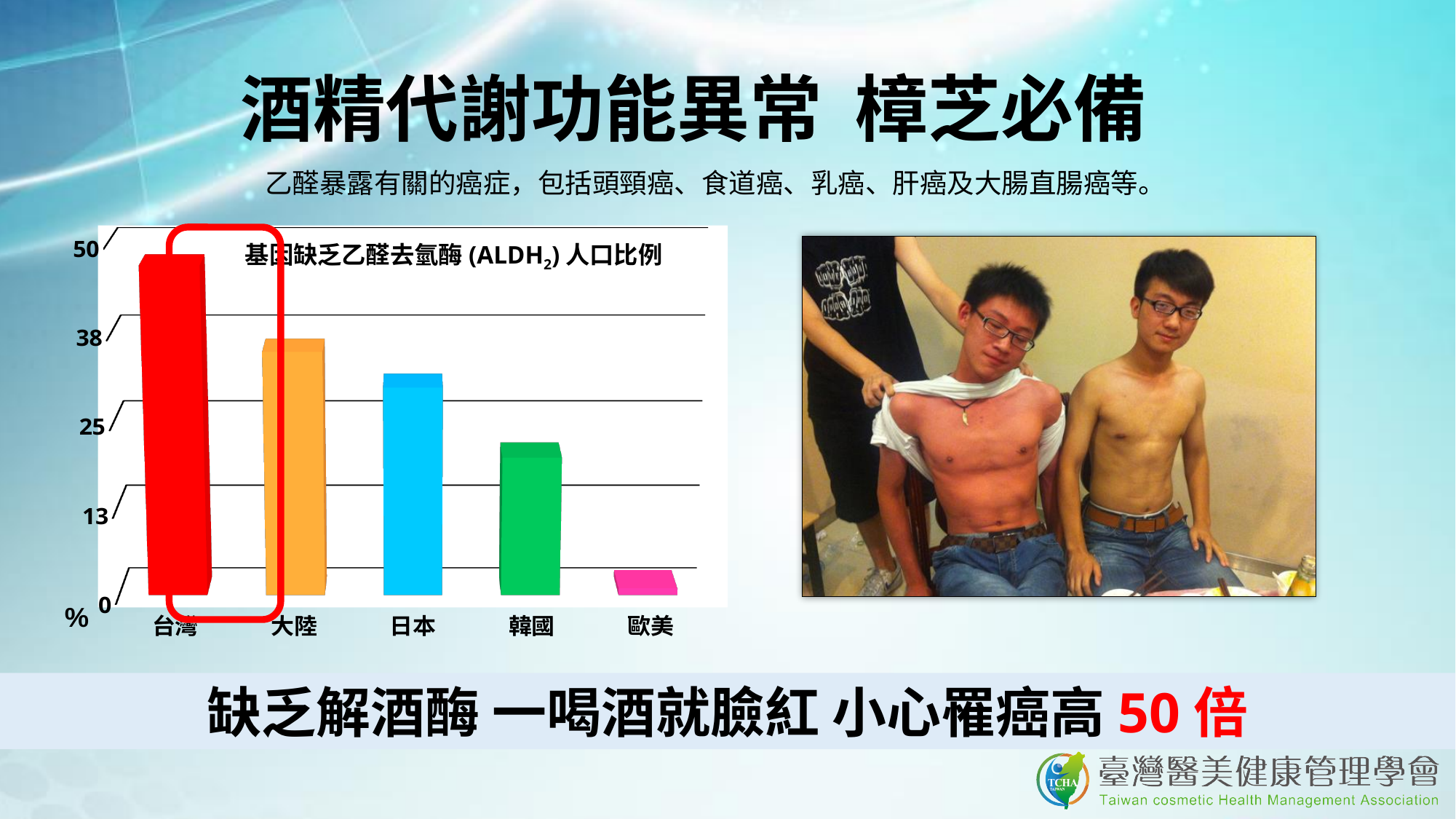
What kind of chart is shown on the slide? bar chart Is the value for 歐美 greater or less than 13? less Do the bar values rise or fall from left to right along the x axis? fall Is the value for 台灣 greater or less than 38? greater What is the title of the chart? 基因缺乏乙醛去氫酶 (ALDH2) 人口比例 Which category has the highest bar in the chart? 台灣 Is the value for 日本 greater or less than 25? greater How many categories are shown on the x axis of the chart? 5 Which category has the lowest bar in the chart? 歐美 Which is larger, the value for 日本 or the value for 韓國? 日本